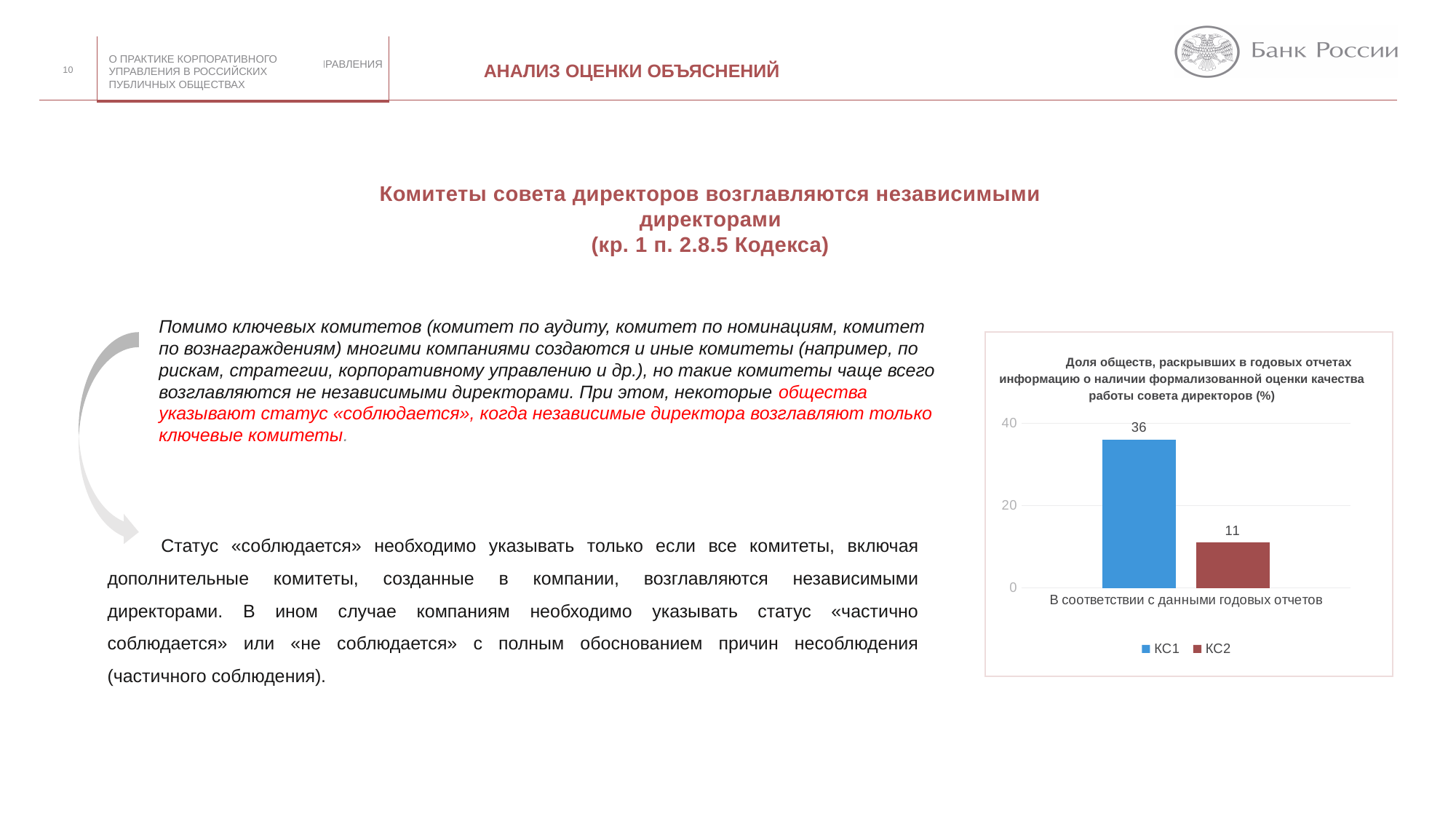
What is the category label on the x axis of the chart? В соответствии с данными годовых отчетов What is the value for КС1 in the chart? 36 What colour is the bar for КС1? blue How many categories are shown on the x axis of the chart? 1 Is the value for КС1 greater or less than 20? greater Which series has the higher value, КС1 or КС2? КС1 Which series has the lowest value in the chart? КС2 What is the value for КС2 in the chart? 11 How many series does the legend list? 2 Is the value for КС2 greater or less than 20? less What kind of chart is shown on the slide? bar chart What is the difference between the values for КС1 and КС2? 25